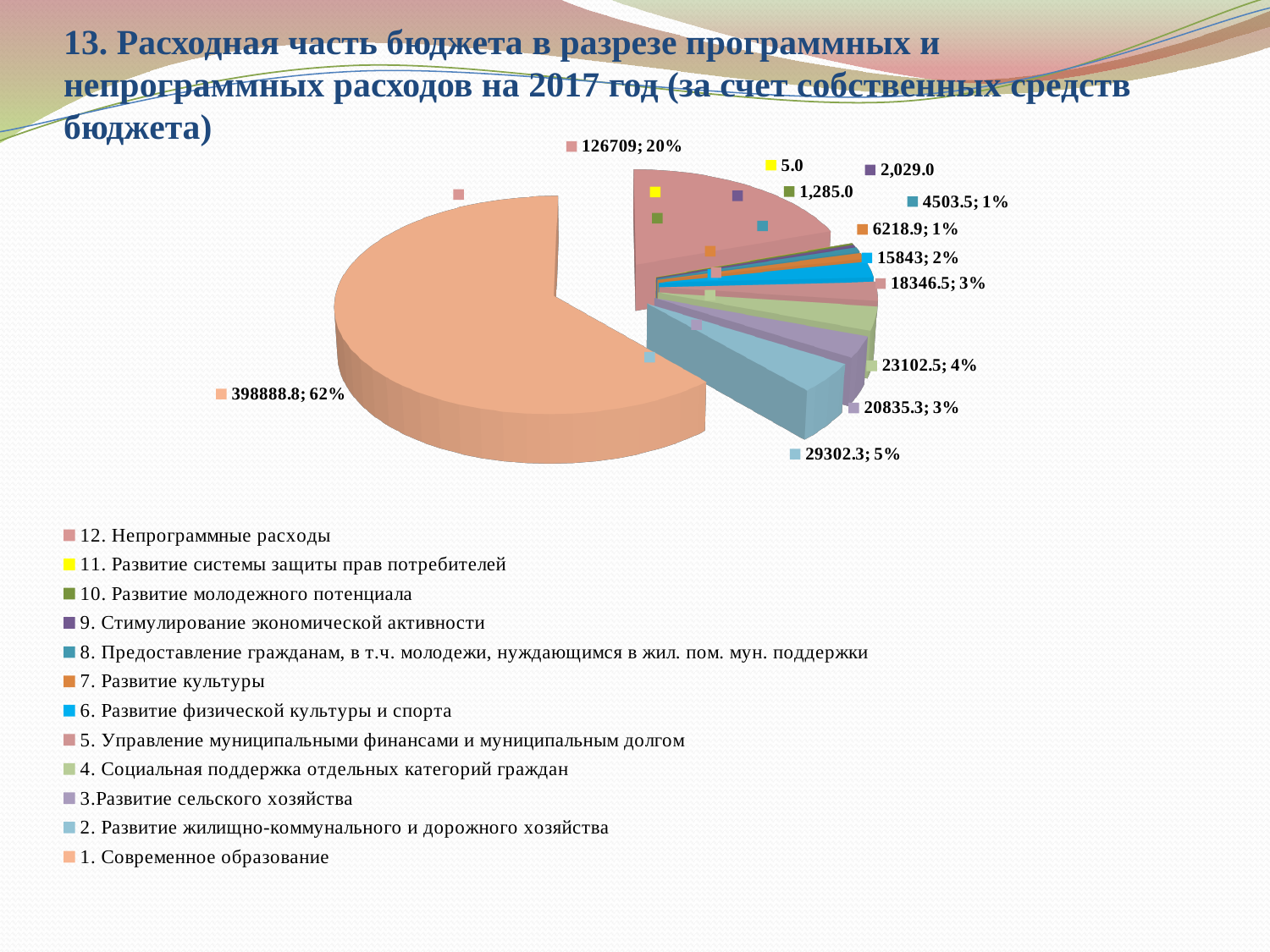
What share of the pie does the slice labelled 15843 represent? 2% Which category has the smallest slice of the pie chart? 11. Развитие системы защиты прав потребителей What share of the pie does the slice labelled 126709 represent? 20% What is the value shown for the slice for '12. Непрограммные расходы'? 126709 What kind of chart is shown on the slide? pie chart What is the value and share shown for the largest slice of the pie chart? 398888.8; 62% What is the value shown for the smallest slice of the pie chart? 5.0 Which category has the largest slice of the pie chart? 1. Современное образование What share of the pie does the slice labelled 29302.3 represent? 5% How many categories does the legend of the pie chart list? 12 What is the difference between the values 398888.8 and 126709 shown on the pie chart? 272179.8 Which is larger: the slice labelled 23102.5 or the slice labelled 20835.3? 23102.5